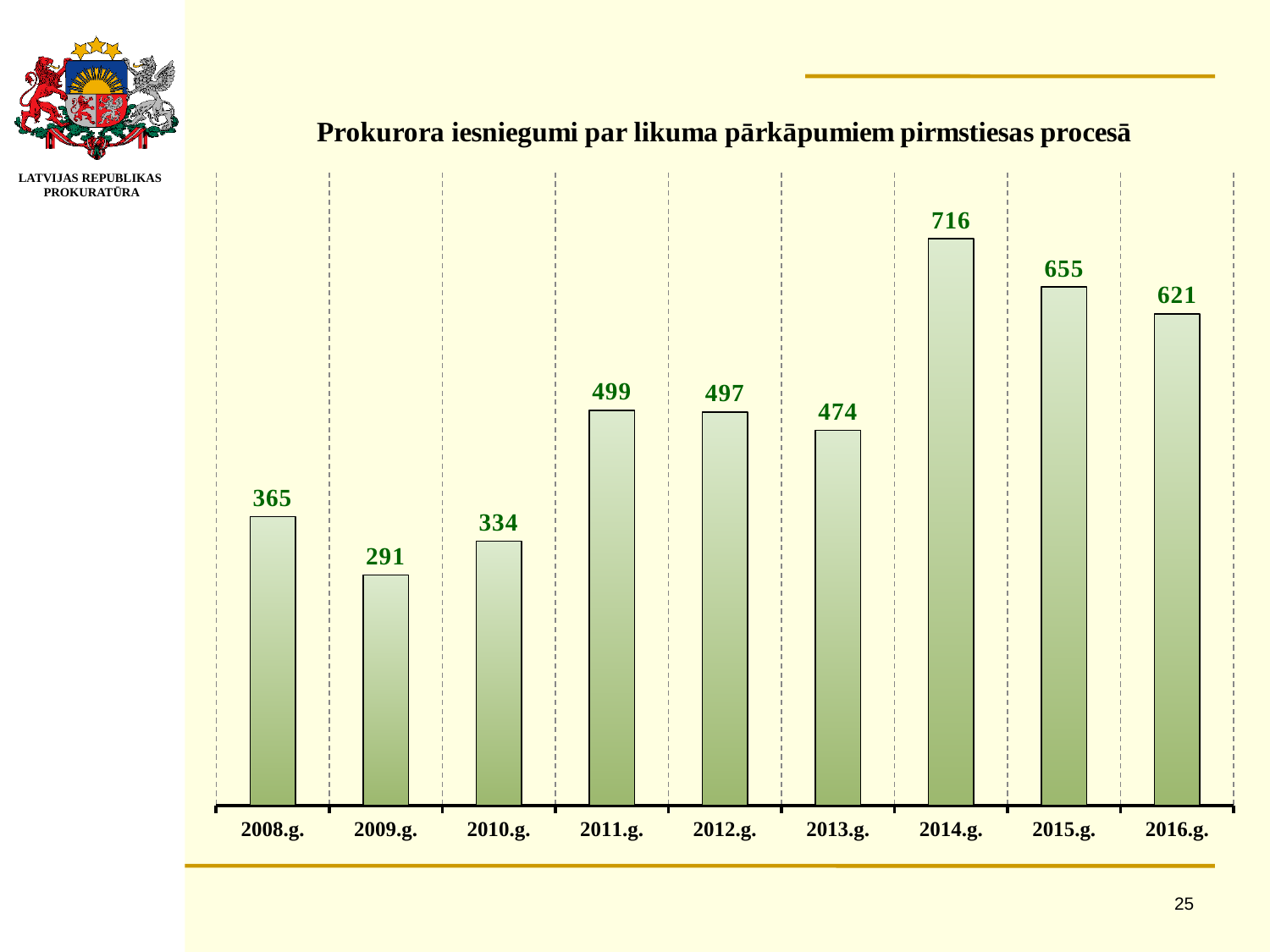
What is the title of the chart? Prokurora iesniegumi par likuma pārkāpumiem pirmstiesas procesā What is the difference between the values for 2014.g. and 2015.g.? 61 What kind of chart is this? bar chart What is the value for 2016.g.? 621 What is the value for 2009.g.? 291 Which year has the highest value? 2014.g. What is the difference between the values for 2008.g. and 2009.g.? 74 Which is larger, the value for 2013.g. or the value for 2016.g.? 2016.g. What is the value for 2014.g.? 716 How many years are shown on the x axis? 9 Do the values rise or fall from 2013.g. to 2014.g.? rise Which year has the lowest value? 2009.g.